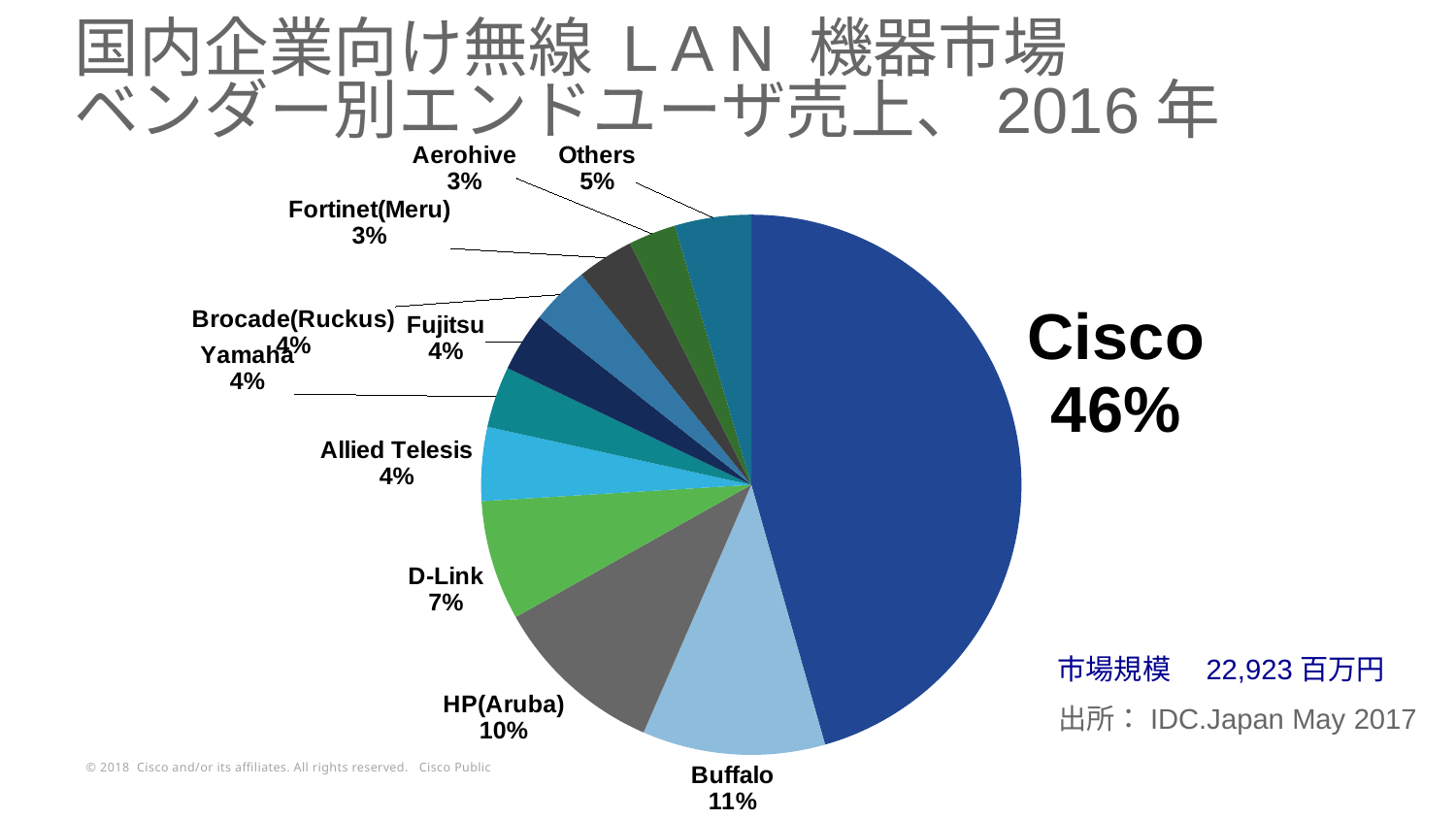
Which is larger, the share for HP(Aruba) or the share for D-Link? HP(Aruba) What is the difference in percentage points between Cisco and Buffalo? 35 What is the combined share of Buffalo and HP(Aruba)? 21% How many slices does the pie chart have? 11 What percentage is shown for Buffalo? 11% Which vendor has the largest slice of the pie? Cisco What percentage is shown for D-Link? 7% What share of the pie does Cisco hold? 46% What percentage is shown for HP(Aruba)? 10% What percentage is shown for Aerohive? 3% What percentage is shown for Others? 5% What kind of chart is shown on the slide? Pie chart